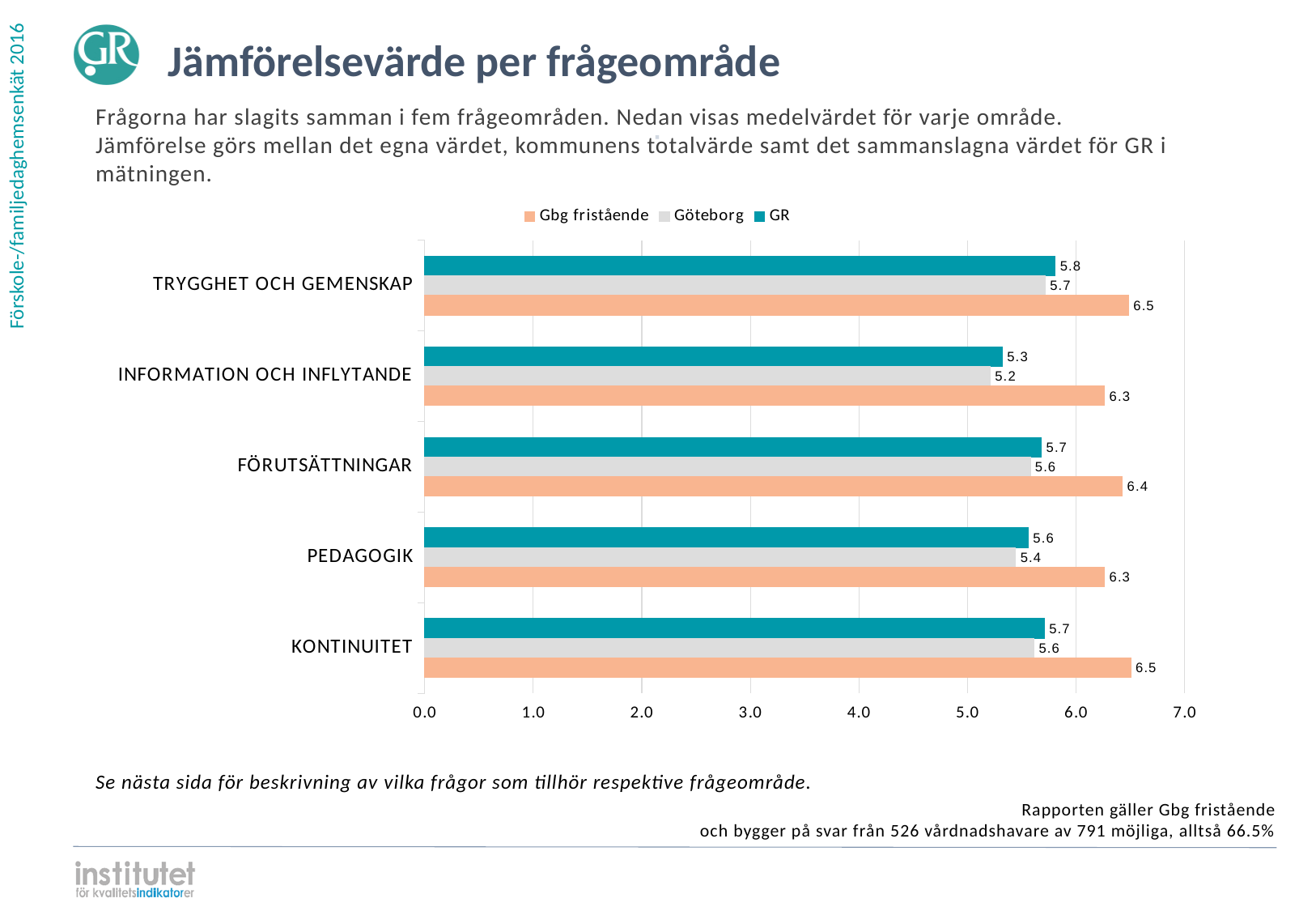
What is the difference between the Gbg fristående and Göteborg values for INFORMATION OCH INFLYTANDE? 1.1 What is the value for GR in the INFORMATION OCH INFLYTANDE category? 5.3 What is the value for Gbg fristående in the TRYGGHET OCH GEMENSKAP category? 6.5 What is the title of the chart on the slide? Jämförelsevärde per frågeområde How many series does the legend list? 3 What is the value for Göteborg in the KONTINUITET category? 5.6 Which is larger for FÖRUTSÄTTNINGAR: the Gbg fristående value or the GR value? Gbg fristående Which category has the lowest value for Göteborg? INFORMATION OCH INFLYTANDE What kind of chart is shown on the slide? Bar chart What is the value for Göteborg in the PEDAGOGIK category? 5.4 Which category has the highest value for GR? TRYGGHET OCH GEMENSKAP How many categories are shown on the chart? 5